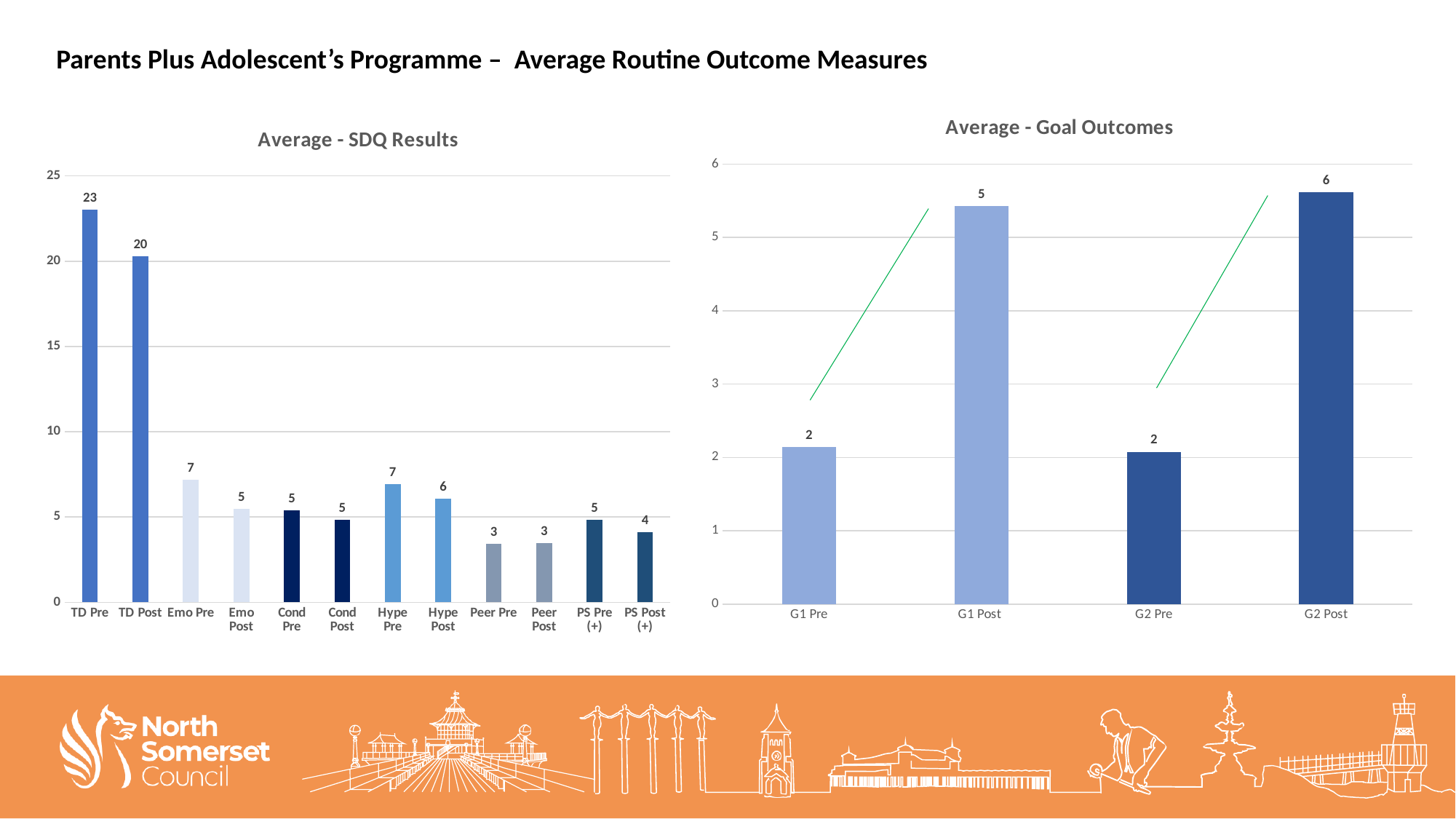
In the Average - SDQ Results chart, is the value for TD Pre greater or less than 20? greater In the Average - SDQ Results chart, what is the difference between TD Pre and TD Post? 3 In the Average - Goal Outcomes chart, what is the value for G1 Post? 5 In the Average - SDQ Results chart, how many categories are shown on the x axis? 12 In the Average - Goal Outcomes chart, how many categories are shown on the x axis? 4 In the Average - SDQ Results chart, which category has the highest value? TD Pre In the Average - SDQ Results chart, which is larger, Hype Pre or Hype Post? Hype Pre In the Average - Goal Outcomes chart, which category has the highest value? G2 Post In the Average - Goal Outcomes chart, what is the difference between G2 Post and G2 Pre? 4 In the Average - SDQ Results chart, what is the value for TD Pre? 23 In the Average - SDQ Results chart, what is the value for Hype Post? 6 What kind of chart is the Average - Goal Outcomes chart? bar chart